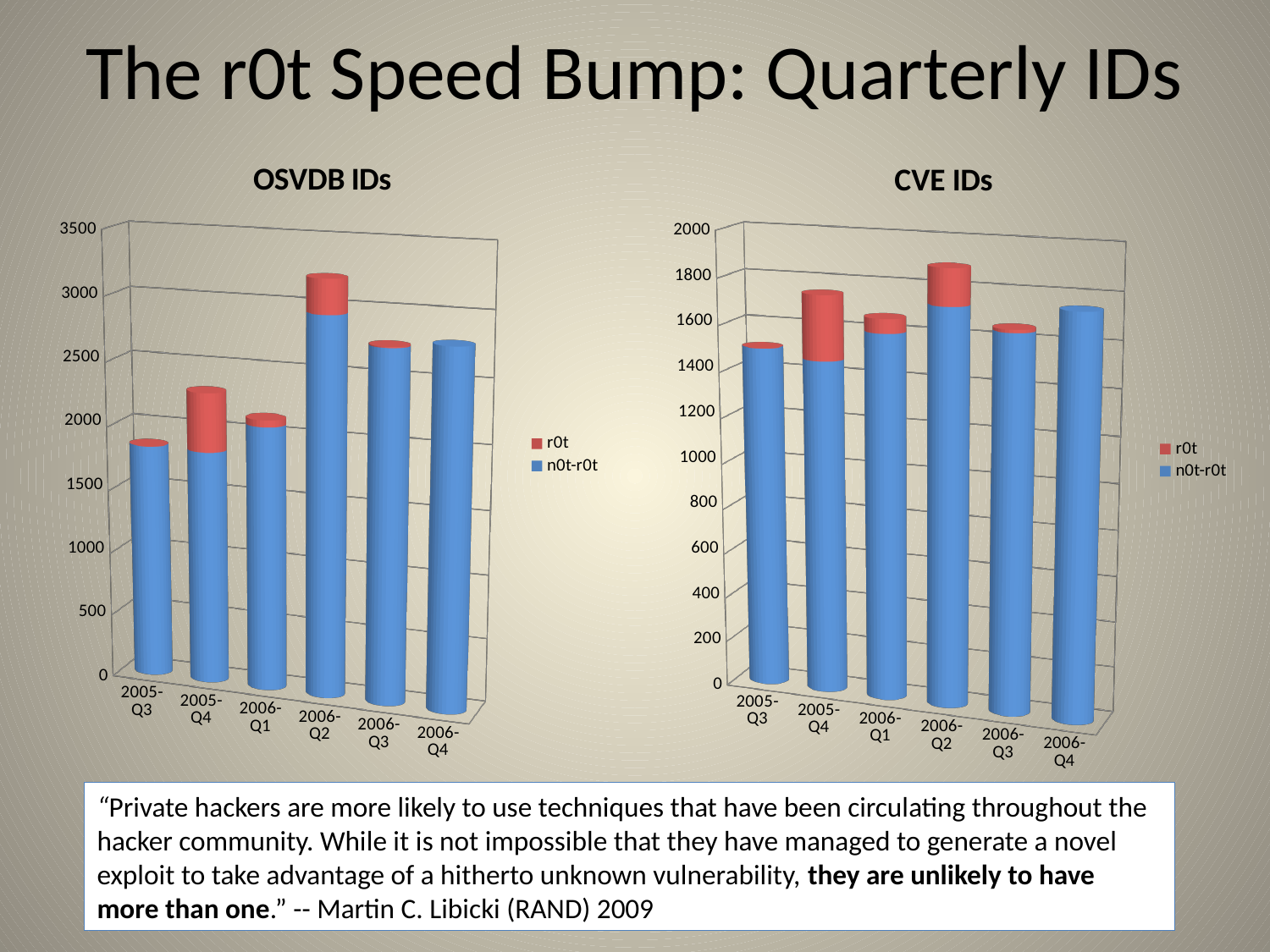
In the CVE IDs chart, is the total bar for 2006-Q2 greater or less than 1600? greater What are the two legend entries in the CVE IDs chart? r0t and n0t-r0t How many quarters are shown on the x axis of the CVE IDs chart? 6 In the CVE IDs chart, which bar is taller, 2005-Q3 or 2005-Q4? 2005-Q4 In the CVE IDs chart, which quarter has the tallest bar? 2006-Q2 In the OSVDB IDs chart, is the total bar for 2005-Q3 greater or less than 2000? less What kind of chart is the OSVDB IDs chart? bar chart How many series does the legend of the OSVDB IDs chart list? 2 In the OSVDB IDs chart, which series is shown in red? r0t In the OSVDB IDs chart, which quarter has the shortest bar? 2005-Q3 In the OSVDB IDs chart, is the total bar for 2006-Q2 greater or less than 2500? greater In the OSVDB IDs chart, which quarter has the tallest bar? 2006-Q2